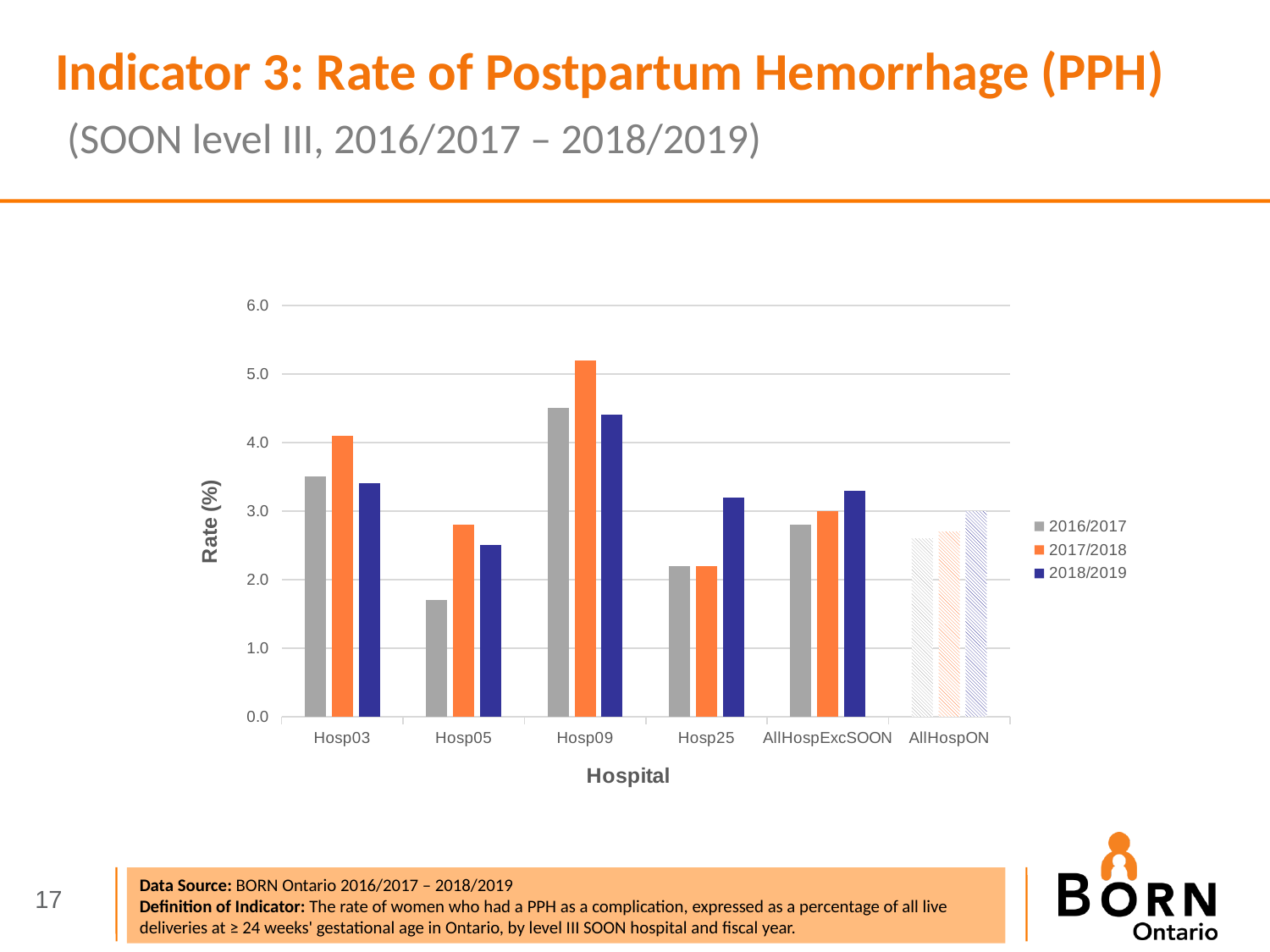
How many hospital categories are shown on the x axis? 6 What is the title of the vertical axis? Rate (%) What kind of chart is shown on the slide? bar chart Is the 2018/2019 value for Hosp25 greater or less than 3.0? greater Which is larger, the 2017/2018 value for Hosp03 or the 2017/2018 value for Hosp25? Hosp03 Which hospital category has the lowest 2016/2017 rate? Hosp05 How many series does the legend list? 3 Is the 2016/2017 value for Hosp05 greater or less than 2.0? less For Hosp25, does the rate rise or fall from 2017/2018 to 2018/2019? rise Which hospital category has the highest 2017/2018 rate? Hosp09 Is the 2017/2018 value for Hosp09 greater or less than 5.0? greater